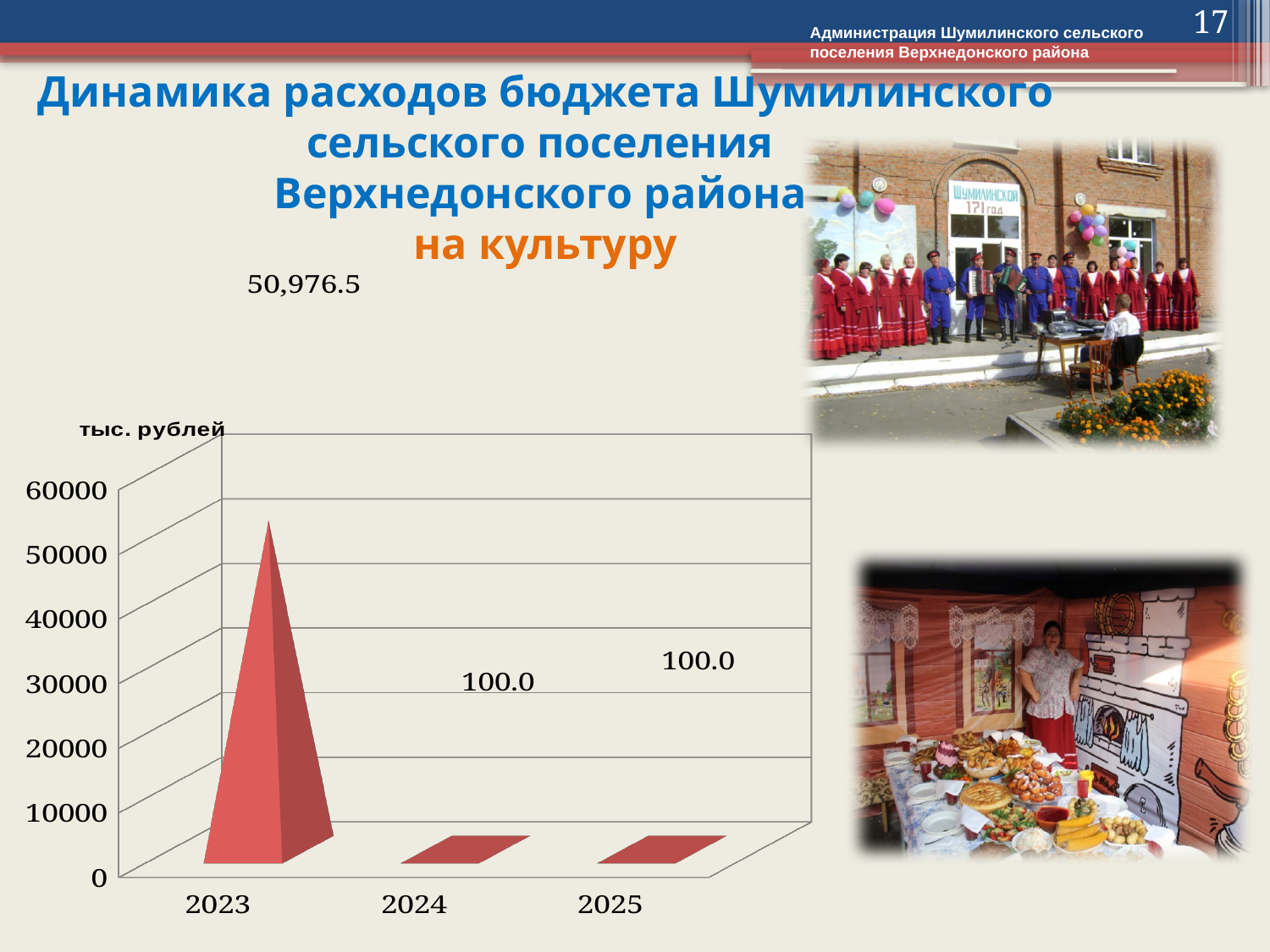
Is the value for 2023 greater or less than 40000? greater What unit is shown on the vertical axis of the chart? тыс. рублей Is the value for 2024 greater or less than 10000? less Which year has the highest value on the chart? 2023 Which is larger, the value for 2023 or the value for 2025? 2023 Do the values rise or fall from 2023 to 2024? fall What is the value for 2025 on the chart? 100.0 What is the difference between the values for 2023 and 2024? 50,876.5 How many years are shown on the x axis of the chart? 3 What kind of chart is shown on the slide? bar chart What is the value for 2023 on the chart? 50,976.5 What is the value for 2024 on the chart? 100.0